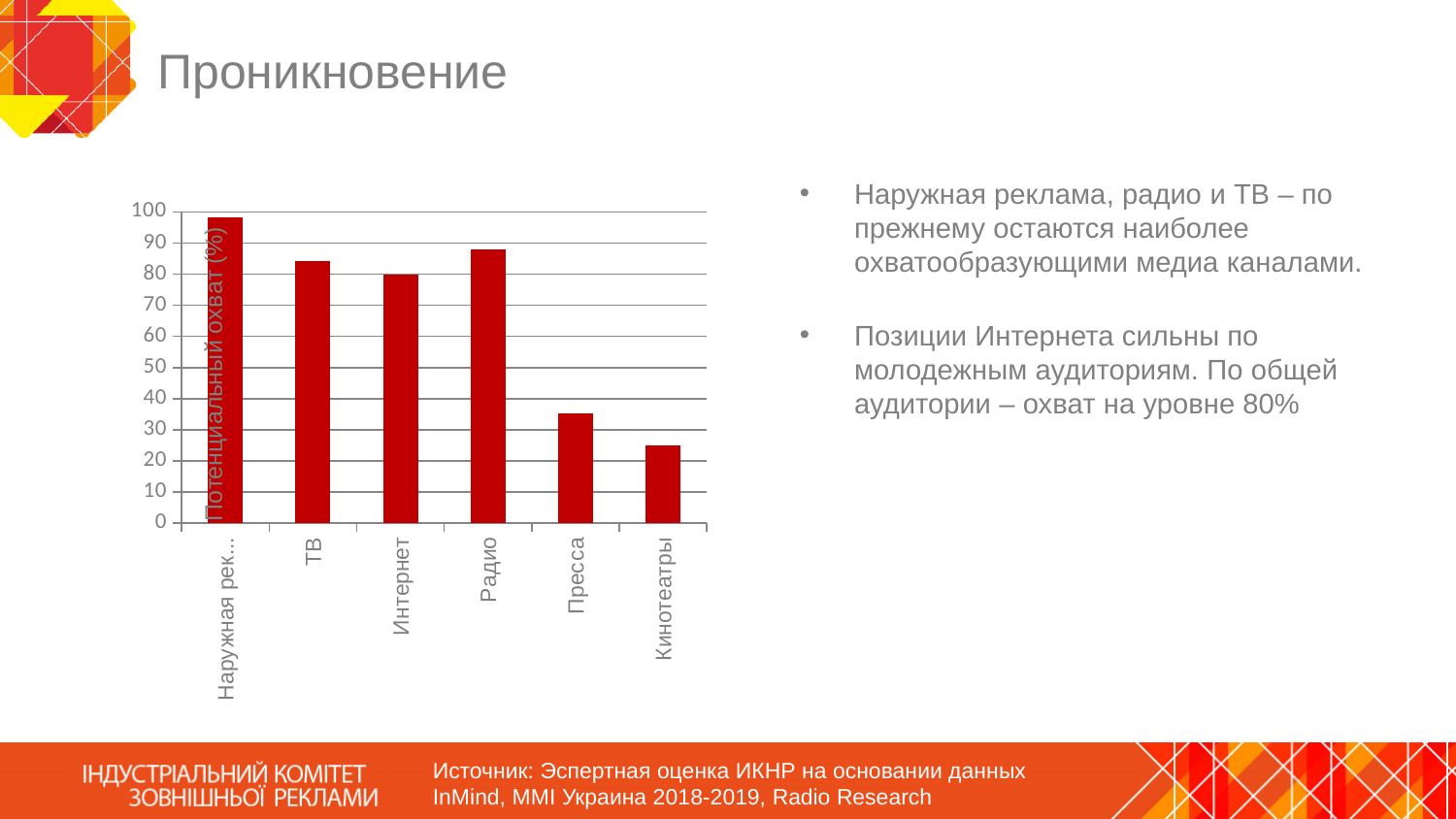
Is the value for Кинотеатры greater or less than 30? less Which has a higher value in the chart, Радио or Интернет? Радио Which category has the lowest potential reach in the chart? Кинотеатры Which has a higher value in the chart, Пресса or Кинотеатры? Пресса Which category has the highest potential reach in the chart? Наружная реклама Is the value for Наружная реклама greater or less than 90? greater Is the value for Пресса greater or less than 40? less What is the label on the vertical axis of the chart? Потенциальный охват (%) How many categories are plotted in the chart? 6 What kind of chart is shown on the slide? bar chart Which has a higher value in the chart, ТВ or Пресса? ТВ